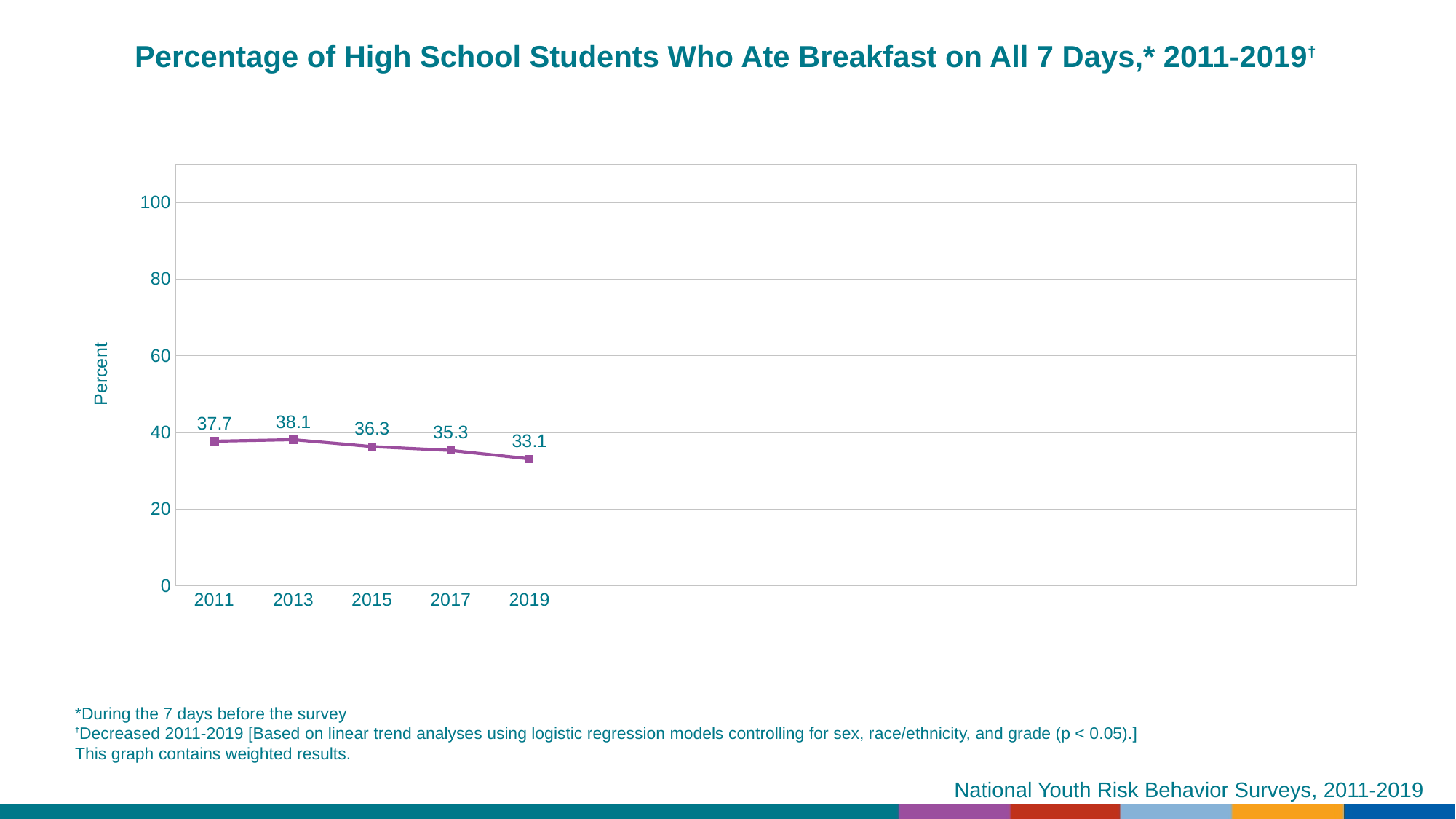
Which year has a larger value, 2015 or 2017? 2015 What is the value plotted for 2015? 36.3 What is the difference between the 2011 value and the 2019 value? 4.6 What kind of chart is shown on the slide? line chart Which year has the lowest percentage of students who ate breakfast on all 7 days? 2019 What is the value plotted for 2019? 33.1 Which year has the highest percentage of students who ate breakfast on all 7 days? 2013 What percentage of high school students ate breakfast on all 7 days in 2011? 37.7 What is the difference between the 2013 value and the 2017 value? 2.8 Do the values generally rise or fall from 2013 to 2019? fall Is the value for 2019 greater or less than 40? less How many years are plotted on the chart? 5